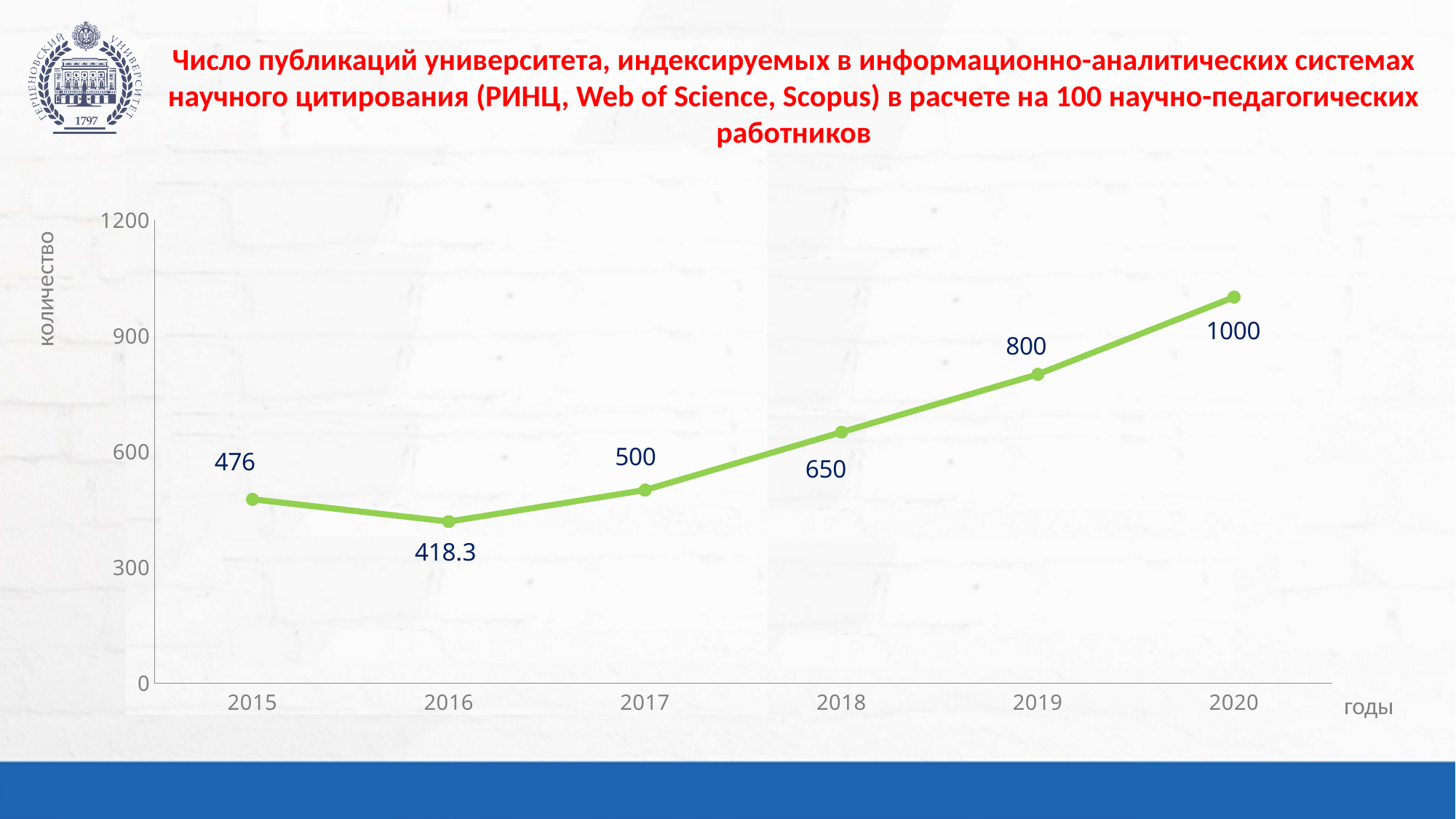
Which year has the highest value? 2020 What is the difference between the values for 2020 and 2019? 200 What is the value for 2016? 418.3 What is the difference between the values for 2015 and 2016? 57.7 What is the value for 2015? 476 What is the value for 2018? 650 What is the value for 2020? 1000 What kind of chart is shown on the slide? line chart How many years are plotted on the chart? 6 Which is larger, the value for 2017 or the value for 2015? 2017 Which year has the lowest value? 2016 Do the values rise or fall from 2016 to 2020? rise